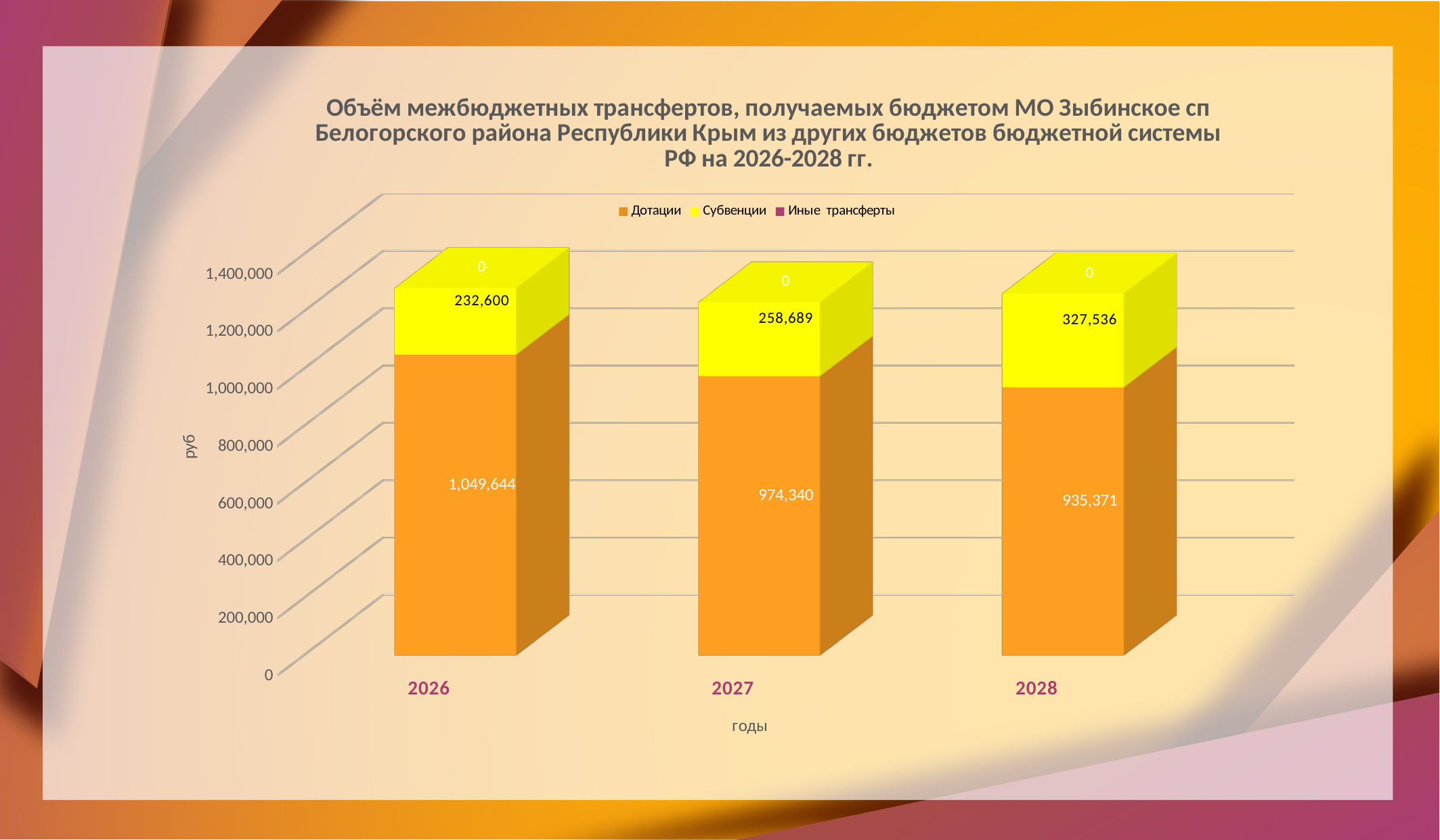
What is the value of Иные трансферты for 2027? 0 What kind of chart is shown on the slide? Stacked bar chart What is the value of Субвенции for 2028? 327,536 What is the difference between Дотации in 2026 and Дотации in 2027? 75,304 What is the total of the stacked bar for 2028? 1,262,907 In which year is Субвенции the lowest? 2026 How many series does the legend list? 3 How many years are shown on the x axis? 3 In which year is Дотации the highest? 2026 What is the value of Дотации for 2026? 1,049,644 Which is larger: Субвенции in 2027 or Субвенции in 2028? Субвенции in 2028 What is the value of Дотации for 2027? 974,340